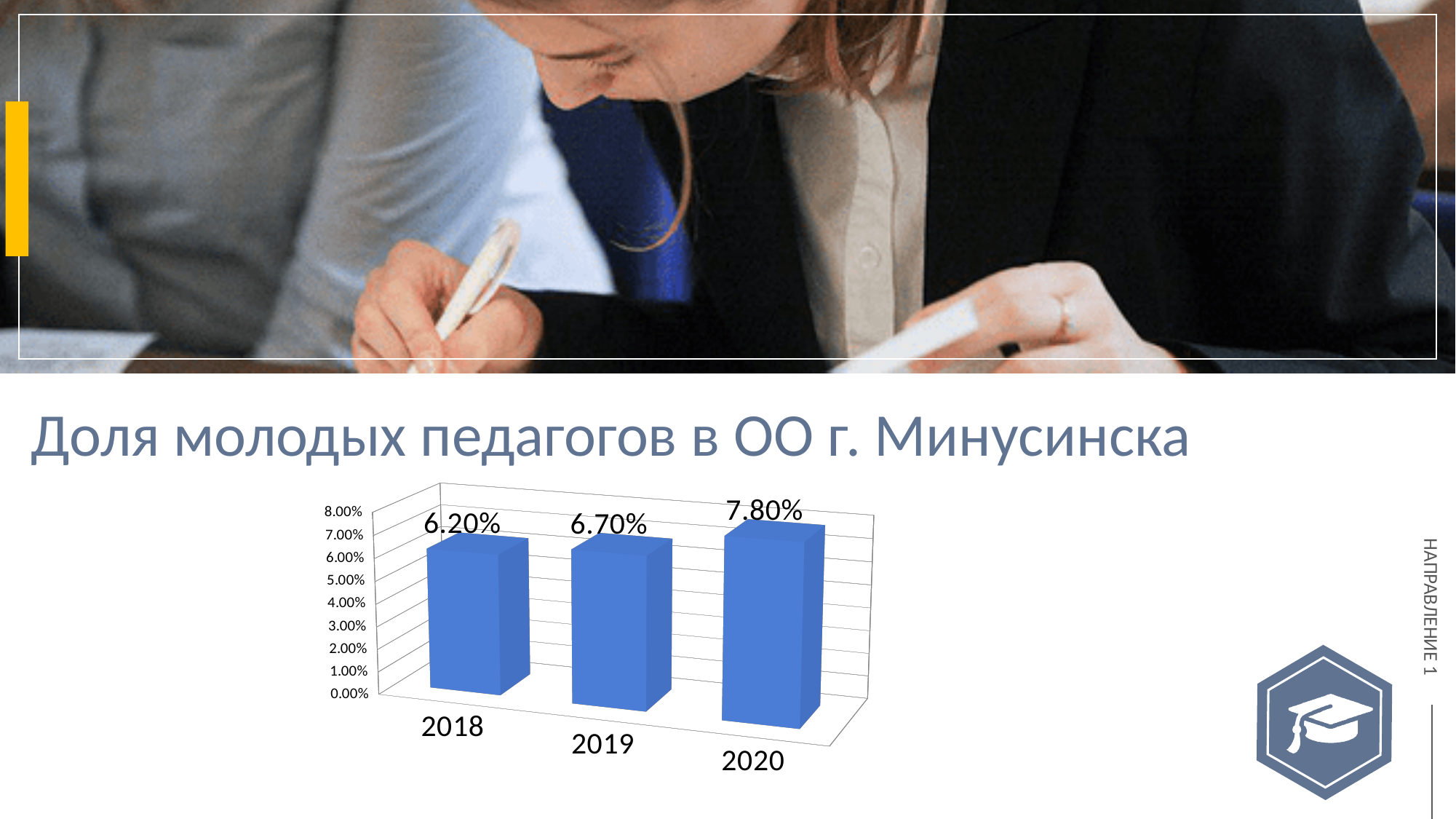
What is the difference between the values for 2019 and 2018? 0.50% Do the values rise or fall from 2018 to 2020? rise What is the difference between the values for 2020 and 2018? 1.60% How many years are shown on the chart? 3 What is the value for 2019? 6.70% Which is larger, the value for 2019 or the value for 2020? 2020 Which year has the highest value? 2020 What is the value for 2018? 6.20% What kind of chart is shown on the slide? bar chart Which year has the lowest value? 2018 Is the value for 2020 greater or less than 7.00%? greater What is the value for 2020? 7.80%